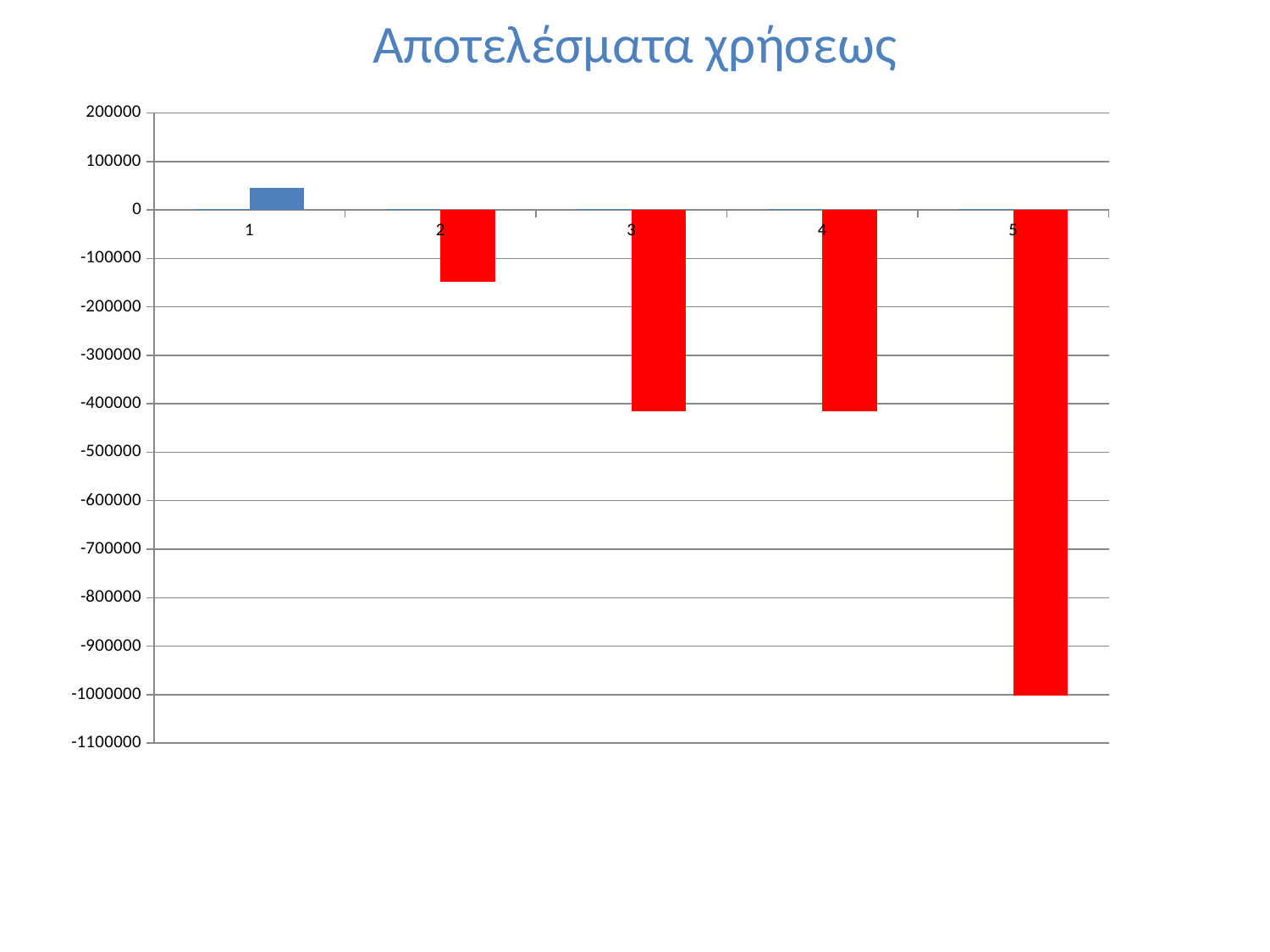
What kind of chart is shown on the slide? bar chart Is the value for category 2 greater or less than -100000? less Which category has the lowest value? 5 Which category has the highest value? 1 Is the value for category 3 greater or less than -400000? less Do the values generally rise or fall from category 1 to category 5? fall Is the value for category 1 greater or less than 0? greater Which is larger, the value for category 2 or the value for category 3? category 2 What is the title of the chart? Αποτελέσματα χρήσεως How many categories are plotted on the x axis? 5